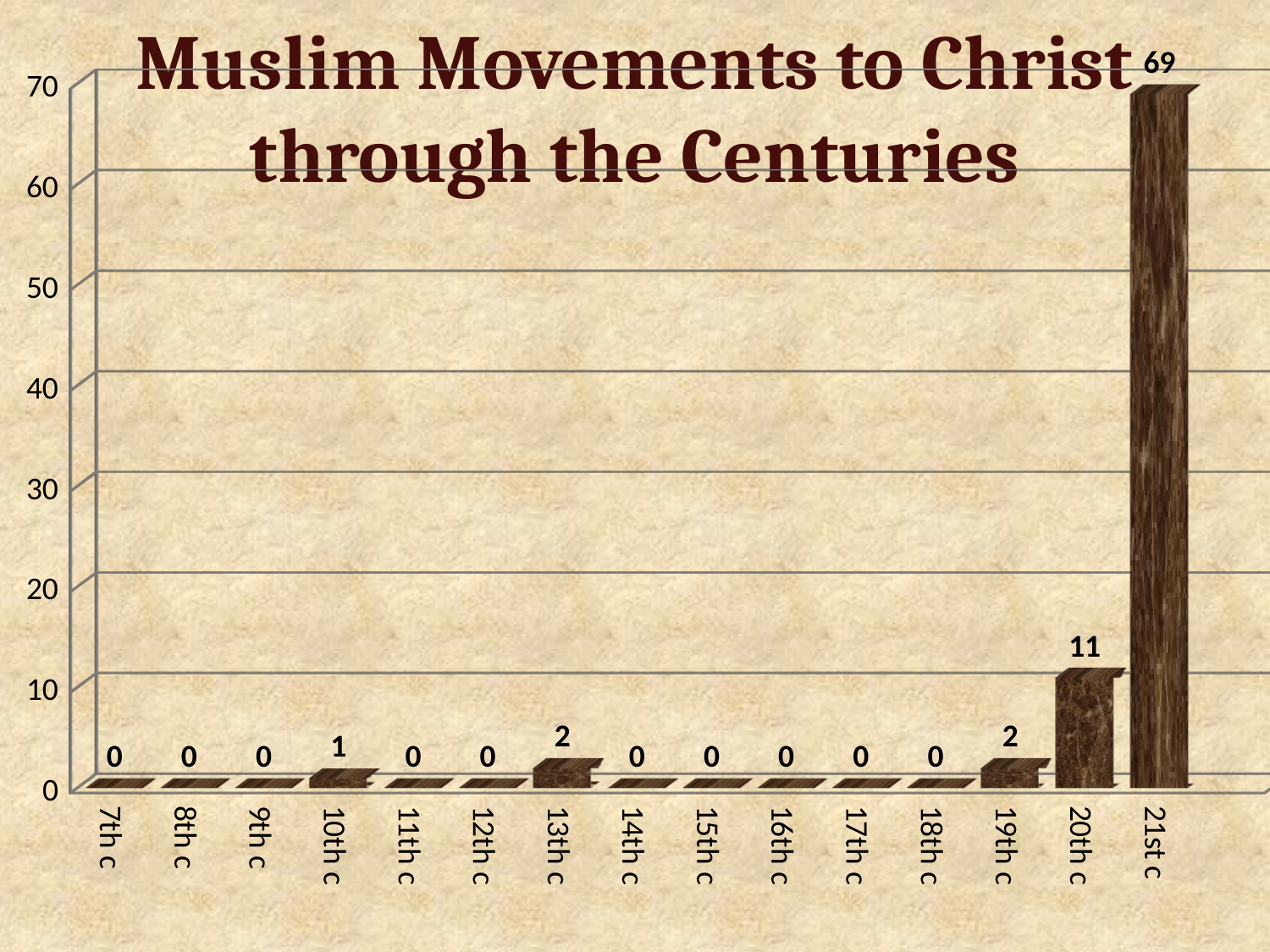
What kind of chart is shown on the slide? bar chart What is the difference between the values for the 21st c and the 20th c? 58 What is the value for the 10th c? 1 Is the value for the 21st c greater or less than 60? greater Which century has the highest value? 21st c What is the value for the 21st c? 69 What is the value for the 20th c? 11 What is the value for the 13th c? 2 What is the title of the chart? Muslim Movements to Christ through the Centuries How many centuries have a value of 0? 10 Which is larger, the value for the 19th c or the value for the 20th c? 20th c How many centuries are shown on the x axis? 15